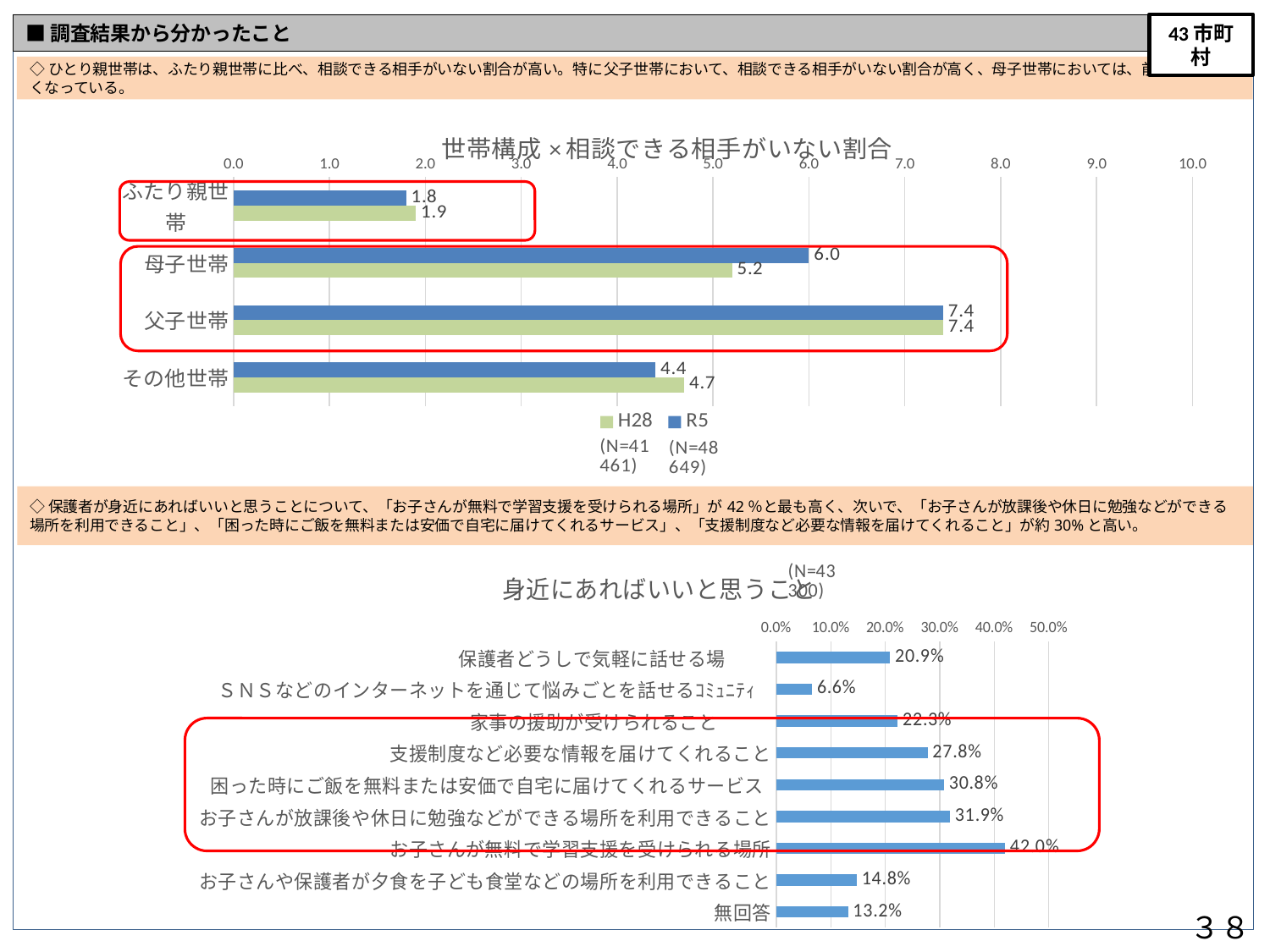
In the chart titled 身近にあればいいと思うこと, which is larger: 家事の援助が受けられること or 保護者どうしで気軽に話せる場? 家事の援助が受けられること In the chart titled 身近にあればいいと思うこと, what is the value for お子さんが無料で学習支援を受けられる場所? 42.0% In the chart titled 世帯構成×相談できる相手がいない割合, how many household categories are shown? 4 In the chart titled 身近にあればいいと思うこと, which item has the lowest value? ＳＮＳなどのインターネットを通じて悩みごとを話せるコミュニティ In the chart titled 世帯構成×相談できる相手がいない割合, what is the R5 value for 母子世帯? 6.0 In the chart titled 世帯構成×相談できる相手がいない割合, what is the difference between the R5 and H28 values for 母子世帯? 0.8 What kind of chart is the chart titled 身近にあればいいと思うこと? Bar chart In the chart titled 世帯構成×相談できる相手がいない割合, which household type has the highest R5 value? 父子世帯 In the chart titled 世帯構成×相談できる相手がいない割合, how many series does the legend list? 2 In the chart titled 世帯構成×相談できる相手がいない割合, which household type has the lowest H28 value? ふたり親世帯 In the chart titled 身近にあればいいと思うこと, what is the difference between お子さんが放課後や休日に勉強などができる場所を利用できること and 困った時にご飯を無料または安価で自宅に届けてくれるサービス? 1.1% In the chart titled 世帯構成×相談できる相手がいない割合, what is the H28 value for その他世帯? 4.7